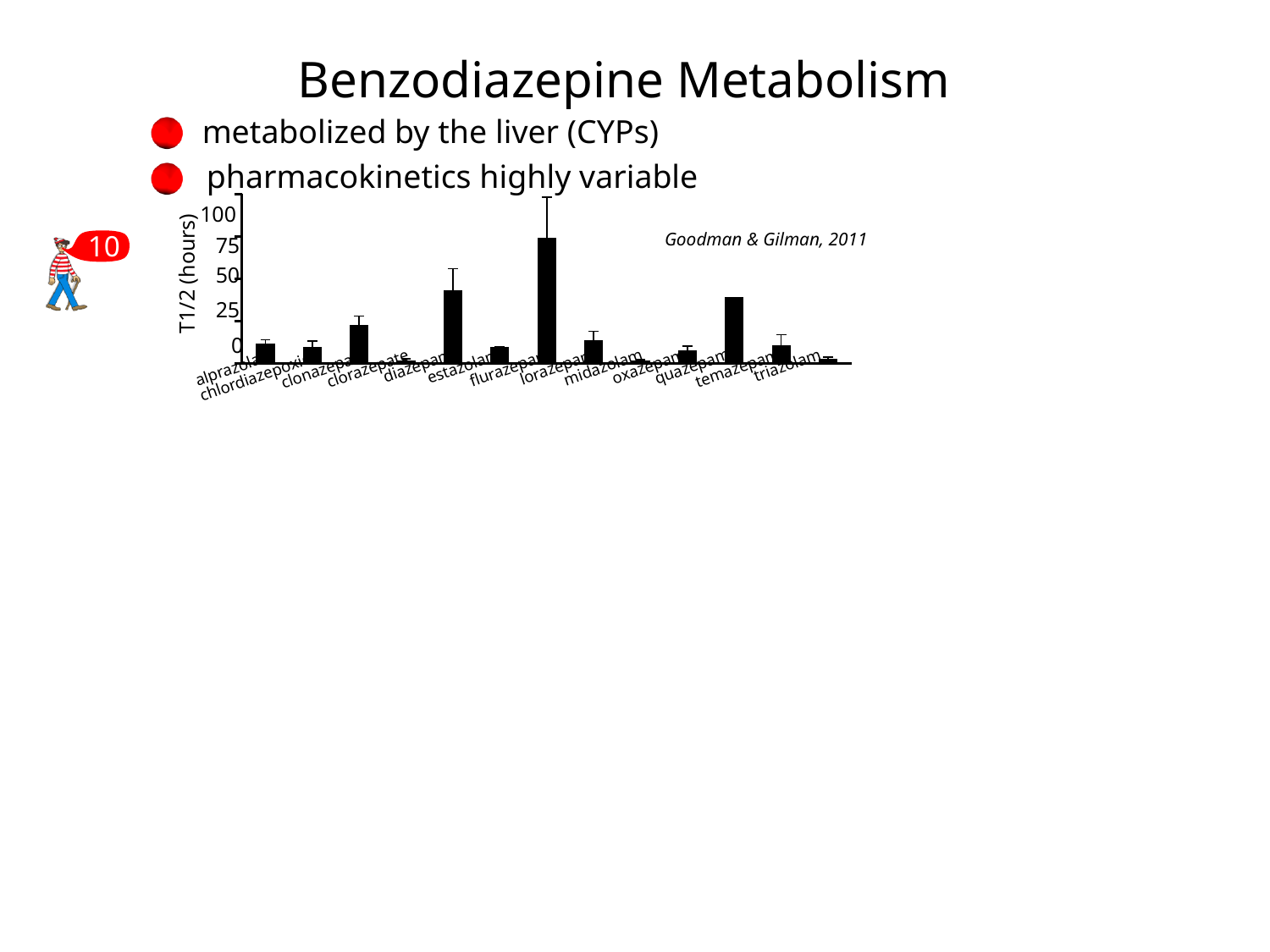
Is the T1/2 value for quazepam greater or less than 25 hours? greater Is the T1/2 value for flurazepam greater or less than 50 hours? greater What is the label on the vertical axis of the chart? T1/2 (hours) Is the T1/2 value for diazepam greater or less than 25 hours? greater What source is cited next to the chart? Goodman & Gilman, 2011 Which has a larger T1/2 value, flurazepam or diazepam? flurazepam Which has a larger T1/2 value, clonazepam or alprazolam? clonazepam What kind of chart is shown on the slide? bar chart Which drug has the highest T1/2 (hours) value in the chart? flurazepam